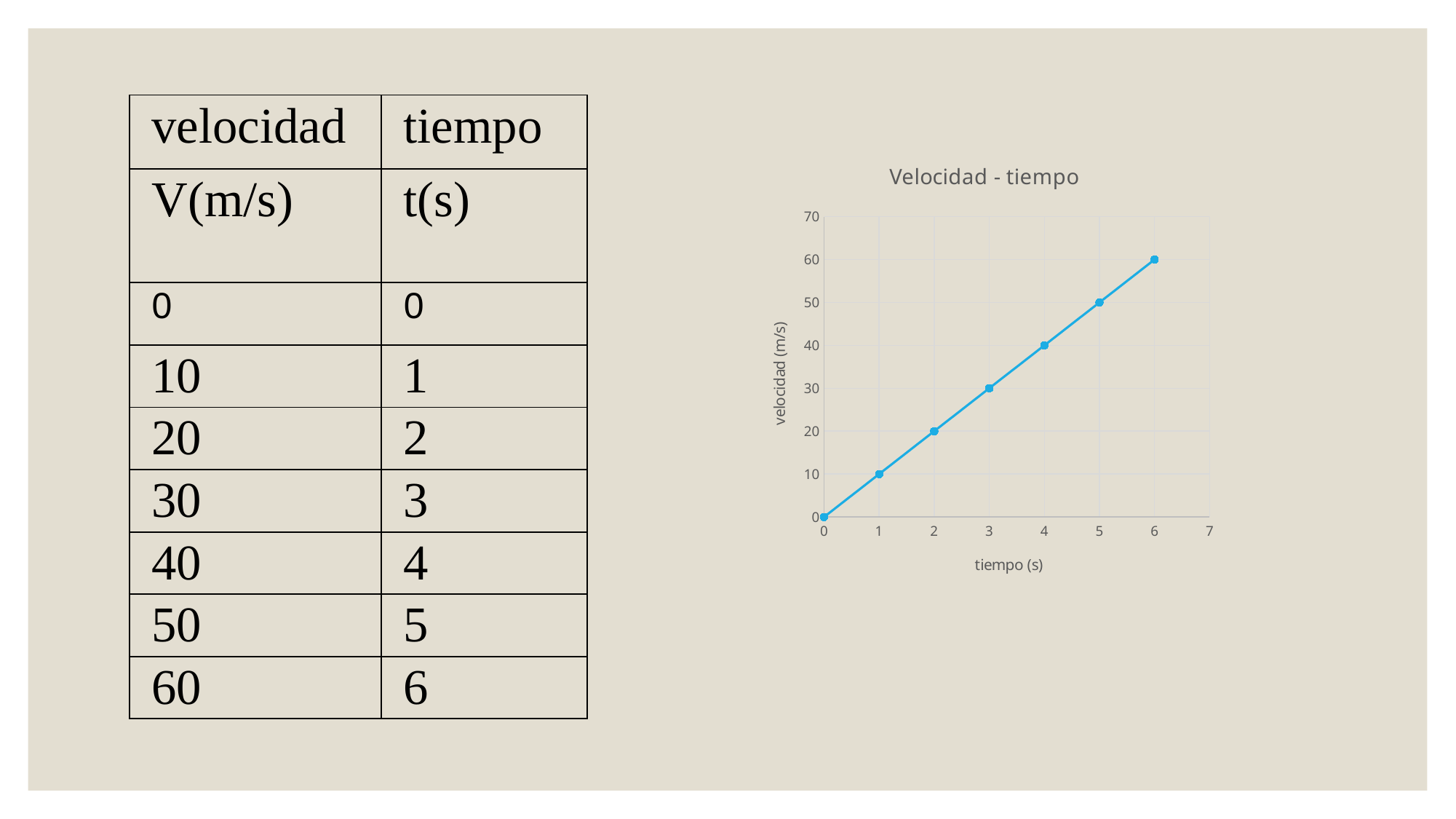
What is the velocity value at tiempo 3 s on the chart? 30 Do the velocity values rise or fall as tiempo increases along the x axis? rise What kind of chart is shown on the slide? line chart How many data points are plotted on the chart? 7 Which is larger, the velocity at tiempo 4 s or at tiempo 2 s? tiempo 4 s What is the label of the y axis of the chart? velocidad (m/s) What is the velocity value at tiempo 6 s on the chart? 60 What is the title of the chart? Velocidad - tiempo At which tiempo value is the velocity lowest on the chart? 0 What is the difference between the velocity at tiempo 5 s and at tiempo 2 s? 30 At which tiempo value is the velocity highest on the chart? 6 What is the velocity value at tiempo 1 s on the chart? 10